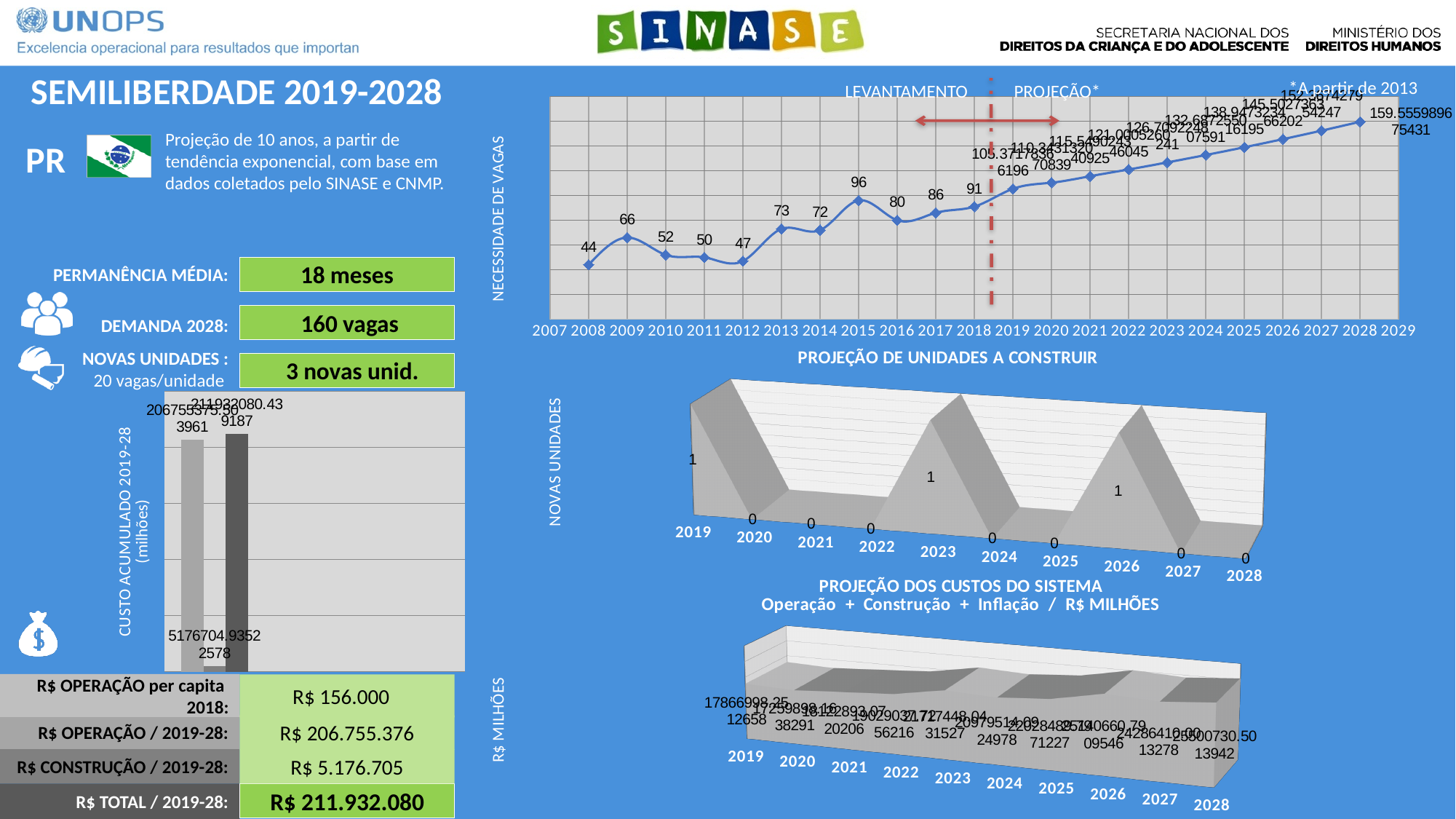
In the NECESSIDADE DE VAGAS chart, do the values rise or fall from 2019 to 2028? rise In the NECESSIDADE DE VAGAS chart, what is the difference between the values for 2015 and 2014? 24 In the NECESSIDADE DE VAGAS chart, which year has the larger value, 2009 or 2010? 2009 In the PROJEÇÃO DE UNIDADES A CONSTRUIR chart, what is the value for 2023? 1 In the NECESSIDADE DE VAGAS chart, which year has the highest value? 2028 How many bars are in the CUSTO ACUMULADO 2019-28 bar chart on the left? 3 In the NECESSIDADE DE VAGAS chart, what is the value for 2018? 91 In the NECESSIDADE DE VAGAS chart, what is the value for 2008? 44 In the NECESSIDADE DE VAGAS chart, what is the value for 2015? 96 What kind of chart is the NECESSIDADE DE VAGAS chart at the top right? line chart In the NECESSIDADE DE VAGAS chart, which year has the lowest value? 2008 In the PROJEÇÃO DE UNIDADES A CONSTRUIR chart, how many years are shown on the x axis? 10